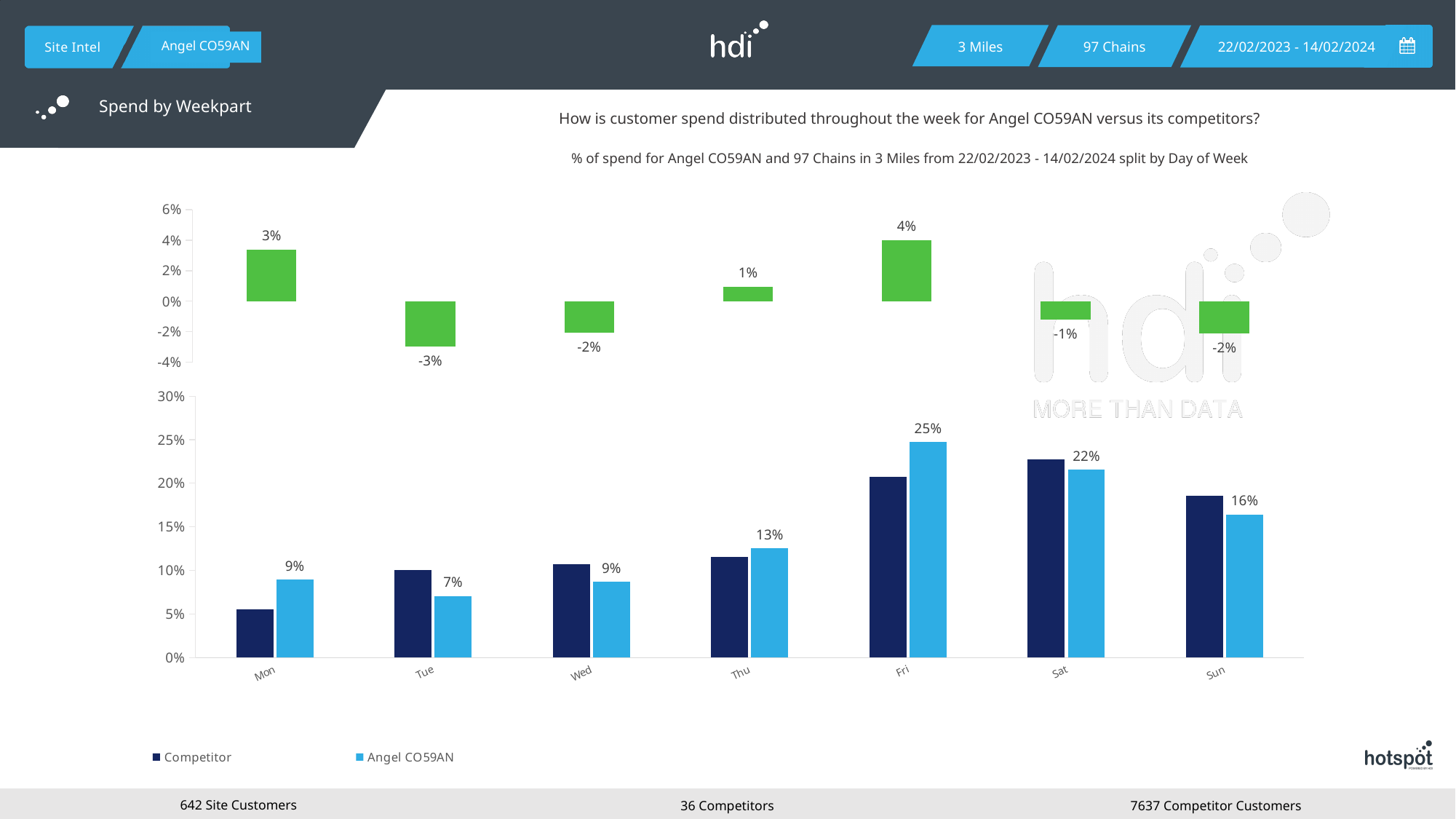
In the bottom chart, is the Competitor value for Sun greater or less than 20%? less In the top chart, what is the value shown for Fri? 4% In the bottom chart, on which day is the Angel CO59AN value highest? Fri In the bottom chart, on which day is the Angel CO59AN value lowest? Tue In the bottom chart, what is the value for Angel CO59AN on Tue? 7% In the bottom chart, what is the difference between the Angel CO59AN values for Fri and Sat? 3% In the top chart, which day has the lowest value? Tue How many series does the legend of the bottom chart list? 2 In the bottom chart, what is the value for Angel CO59AN on Fri? 25% What kind of chart is the bottom chart? Bar chart In the bottom chart, on Sat, which series has the larger value, Competitor or Angel CO59AN? Competitor In the top chart, what is the value shown for Tue? -3%